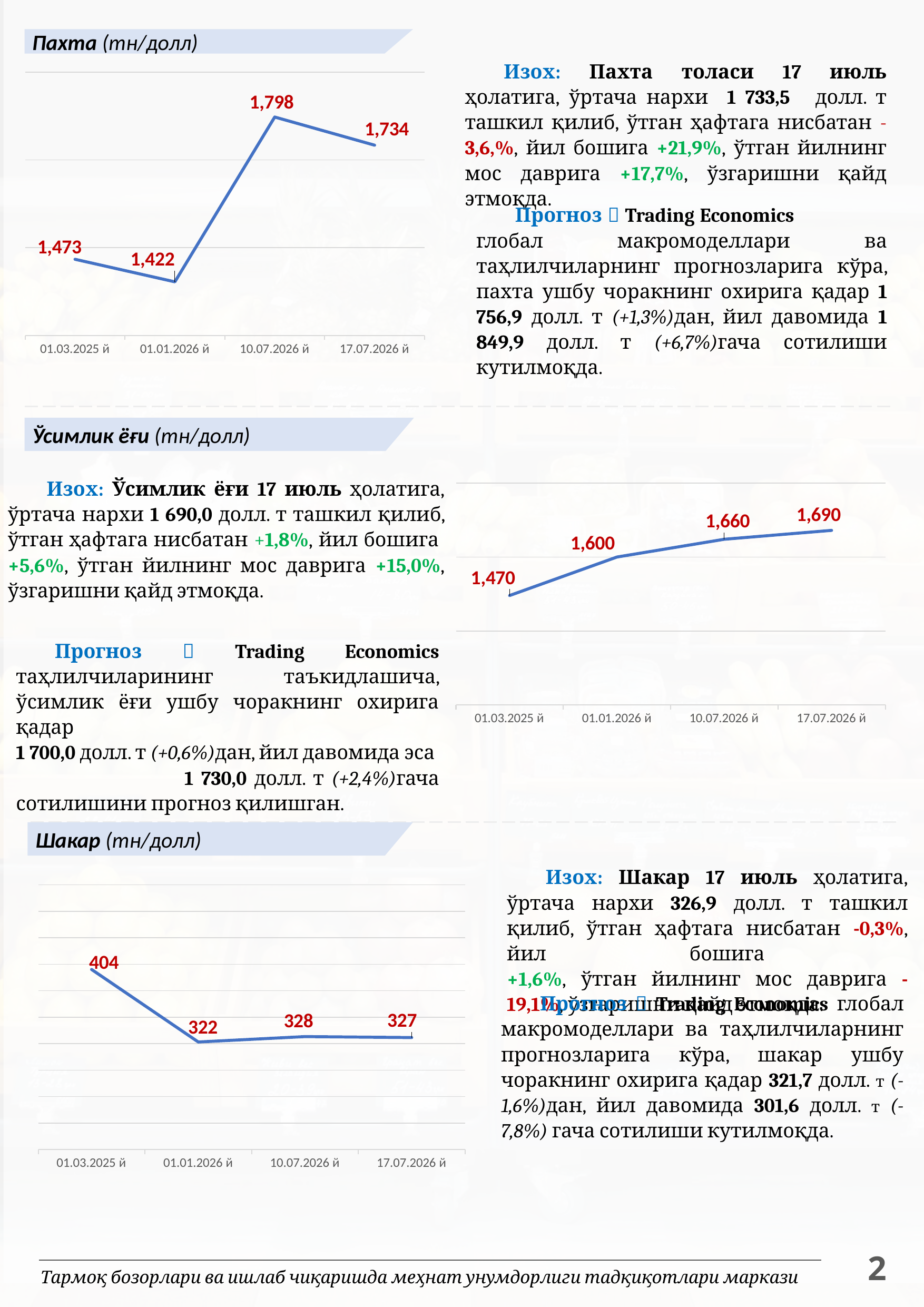
On the Шакар (тн/долл) chart, what is the value for 01.03.2025 й? 404 On the Пахта (тн/долл) chart, how many data points are plotted? 4 On the Шакар (тн/долл) chart, which is larger: the value for 01.03.2025 й or the value for 17.07.2026 й? 01.03.2025 й On the Ўсимлик ёғи (тн/долл) chart, which date has the highest value? 17.07.2026 й On the Пахта (тн/долл) chart, which date has the lowest value? 01.01.2026 й On the Шакар (тн/долл) chart, which date has the lowest value? 01.01.2026 й On the Ўсимлик ёғи (тн/долл) chart, do the values rise or fall from left to right along the x axis? rise On the Ўсимлик ёғи (тн/долл) chart, what is the value for 01.03.2025 й? 1,470 On the Ўсимлик ёғи (тн/долл) chart, what is the difference between the values for 01.01.2026 й and 01.03.2025 й? 130 On the Пахта (тн/долл) chart, what is the value for 10.07.2026 й? 1,798 What type of chart is the Шакар (тн/долл) chart? line chart On the Пахта (тн/долл) chart, what is the difference between the values for 10.07.2026 й and 17.07.2026 й? 64